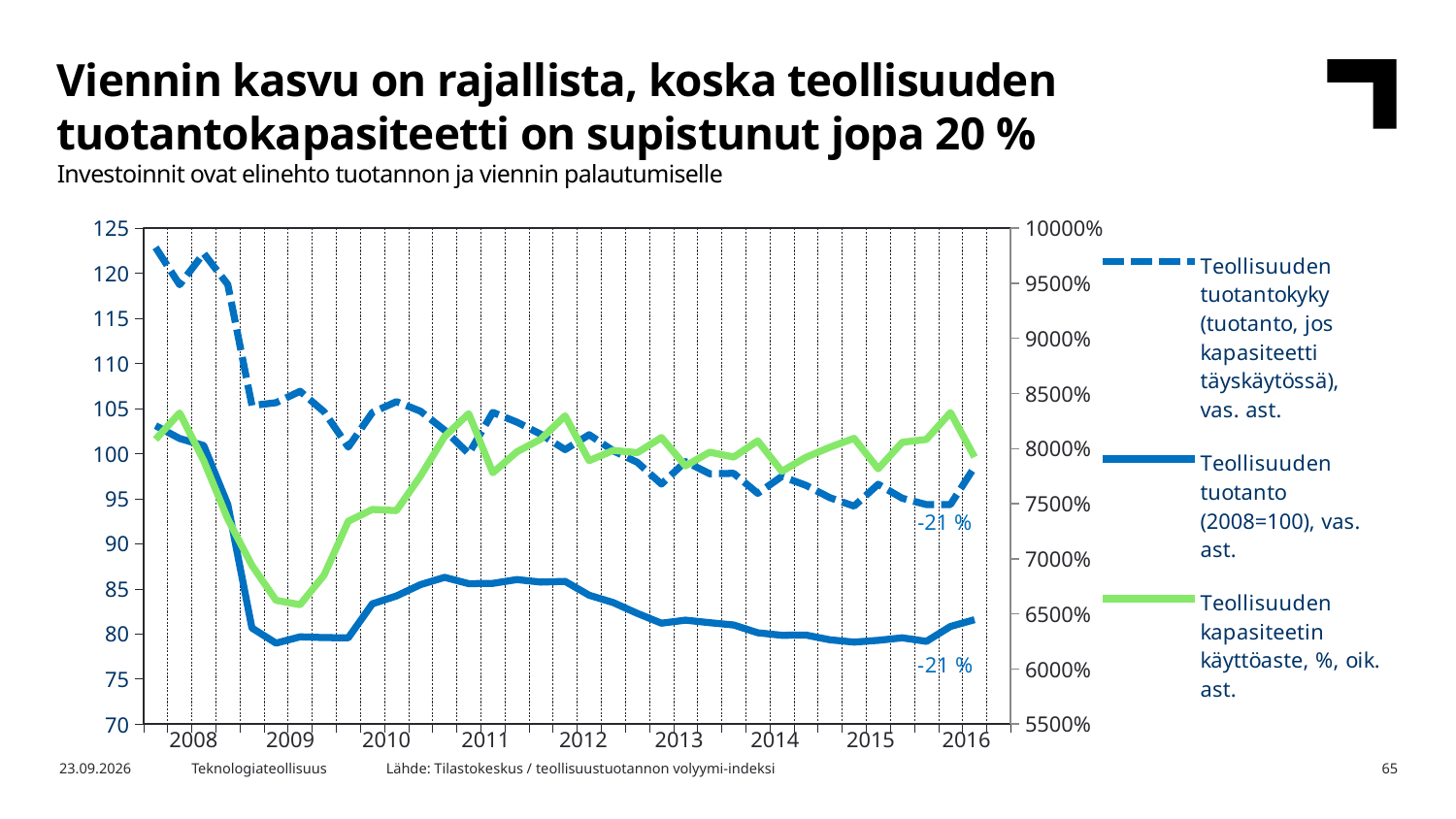
Does the dashed blue line (Teollisuuden tuotantokyky) rise or fall overall from 2008 to 2016? fall At the end of 2016, which is higher: the dashed blue line (Teollisuuden tuotantokyky) or the solid blue line (Teollisuuden tuotanto)? Teollisuuden tuotantokyky (dashed blue line) How many year labels are shown on the x axis? 9 At the start of 2008, is the value of the dashed blue line (Teollisuuden tuotantokyky) greater or less than 120 on the left axis? greater How many series does the legend list? 3 Which series is drawn with a dashed line? Teollisuuden tuotantokyky (tuotanto, jos kapasiteetti täyskäytössä), vas. ast. At the end of 2016, is the value of the solid blue line (Teollisuuden tuotanto) greater or less than 85 on the left axis? less At the end of 2016, is the value of the dashed blue line (Teollisuuden tuotantokyky) greater or less than 100 on the left axis? less Which series reaches the highest point on the left axis? Teollisuuden tuotantokyky (dashed blue line) What kind of chart is shown on the slide? line chart Does the solid blue line (Teollisuuden tuotanto) rise or fall overall from 2008 to 2016? fall What annotation is printed near the end of the two blue lines? -21 %